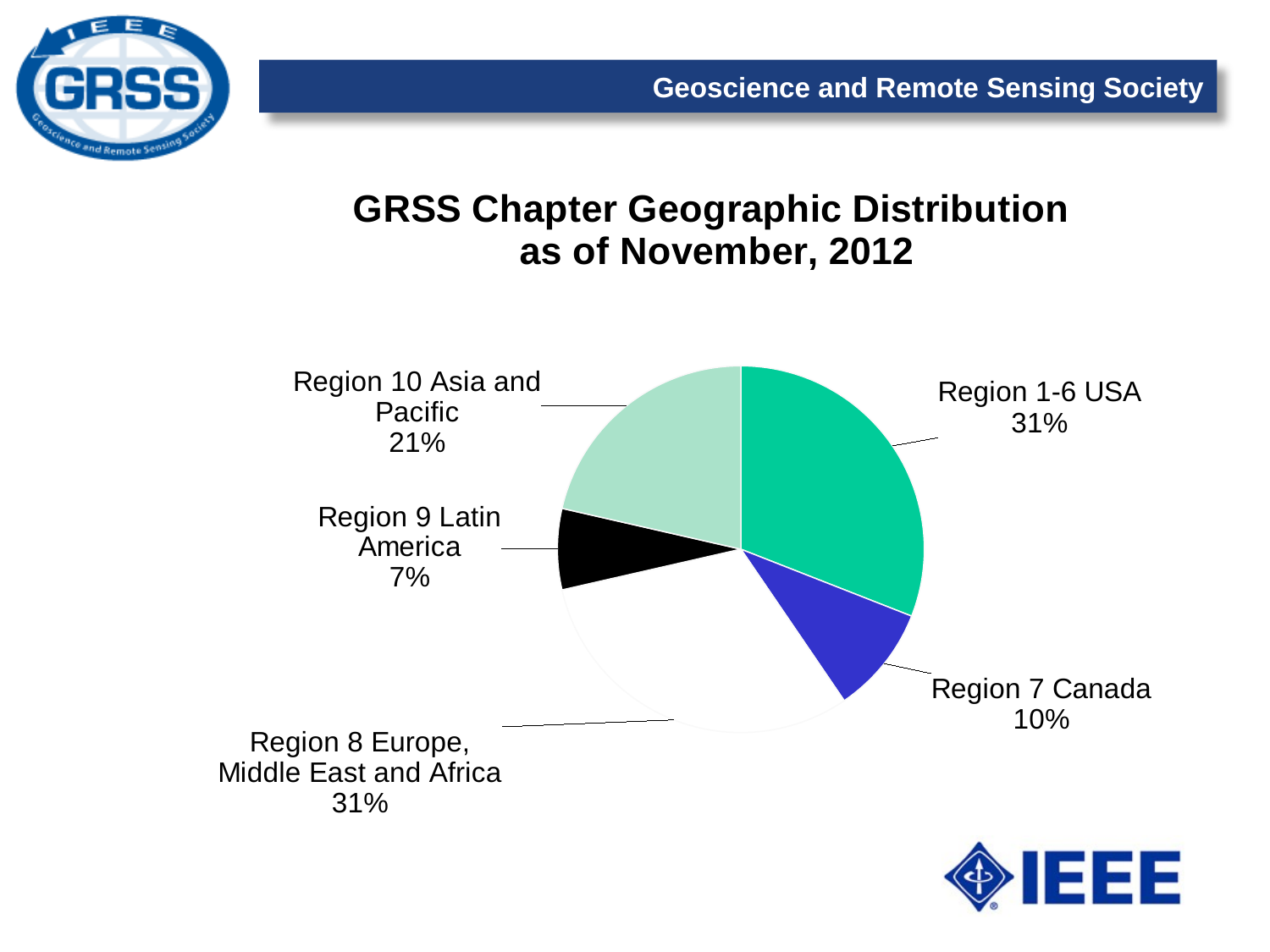
What is the value shown for Region 9 Latin America? 7% What is the title of the chart? GRSS Chapter Geographic Distribution as of November, 2012 What is the value shown for Region 1-6 USA? 31% By how many percentage points does Region 10 Asia and Pacific exceed Region 7 Canada? 11 percentage points What share of the pie does Region 10 Asia and Pacific have? 21% What share of the pie does Region 7 Canada have? 10% Which region has the smallest slice of the pie? Region 9 Latin America How many slices does the pie chart have? 5 By how many percentage points does Region 1-6 USA exceed Region 9 Latin America? 24 percentage points Which is larger, the share for Region 10 Asia and Pacific or the share for Region 7 Canada? Region 10 Asia and Pacific What kind of chart is shown on the slide? pie chart What is the value shown for Region 8 Europe, Middle East and Africa? 31%